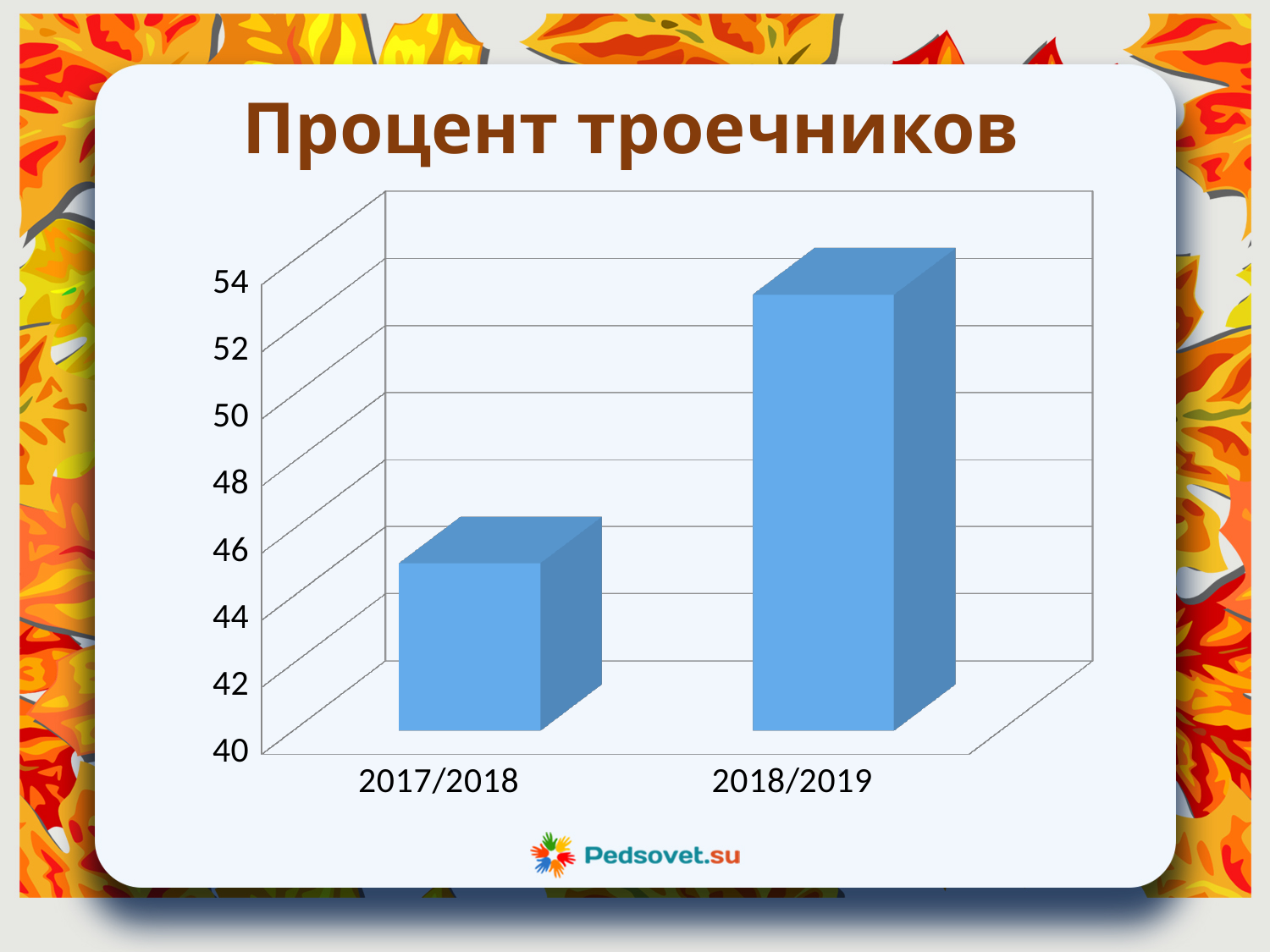
Is the value for 2017/2018 greater or less than 48? less Is the value for 2018/2019 greater or less than 50? greater Do the values rise or fall from 2017/2018 to 2018/2019? rise Which category has the lowest value? 2017/2018 Is the value for 2017/2018 greater or less than 42? greater What is the lowest value shown on the vertical axis? 40 Which category has the highest value? 2018/2019 Which is larger, the value for 2017/2018 or the value for 2018/2019? 2018/2019 What is the title of the chart? Процент троечников How many categories are plotted on the x axis? 2 What kind of chart is shown on the slide? bar chart